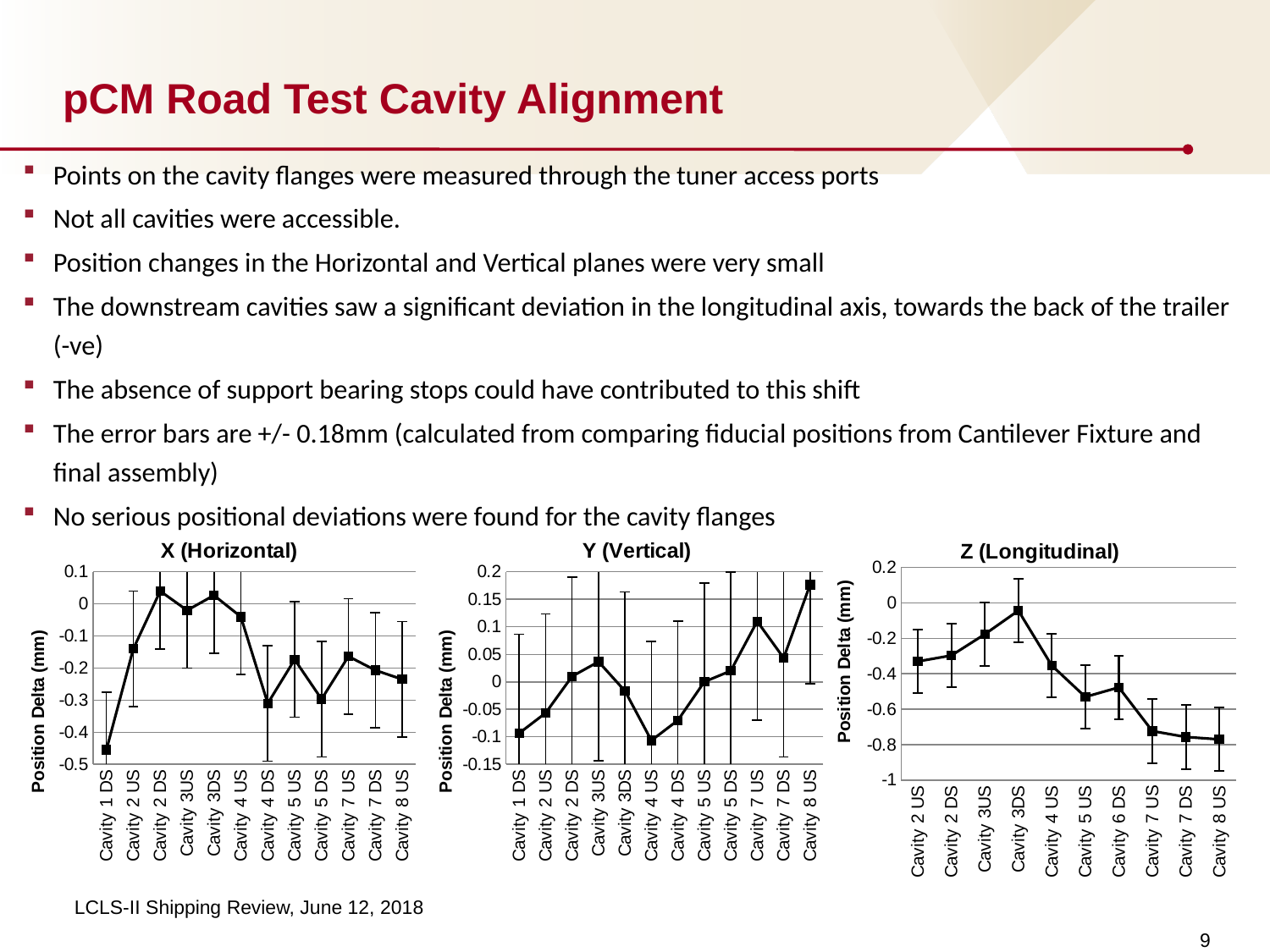
On the Z (Longitudinal) chart, do the values rise or fall from Cavity 3DS to Cavity 8 US? fall How many data points are plotted on the Z (Longitudinal) chart? 10 On the X (Horizontal) chart, is the value for Cavity 1 DS greater or less than -0.4? less On the Y (Vertical) chart, is the value for Cavity 8 US greater or less than 0.15? greater How many data points are plotted on the Y (Vertical) chart? 12 What kind of chart is the X (Horizontal) chart? Line chart On the X (Horizontal) chart, which is larger, the value for Cavity 4 DS or Cavity 5 US? Cavity 5 US On the Y (Vertical) chart, which cavity point has the highest position delta? Cavity 8 US On the Z (Longitudinal) chart, which cavity point has the highest position delta? Cavity 3DS On the Z (Longitudinal) chart, is the value for Cavity 8 US greater or less than -0.6? less What is the y-axis label on the Z (Longitudinal) chart? Position Delta (mm) On the X (Horizontal) chart, which cavity point has the lowest position delta? Cavity 1 DS